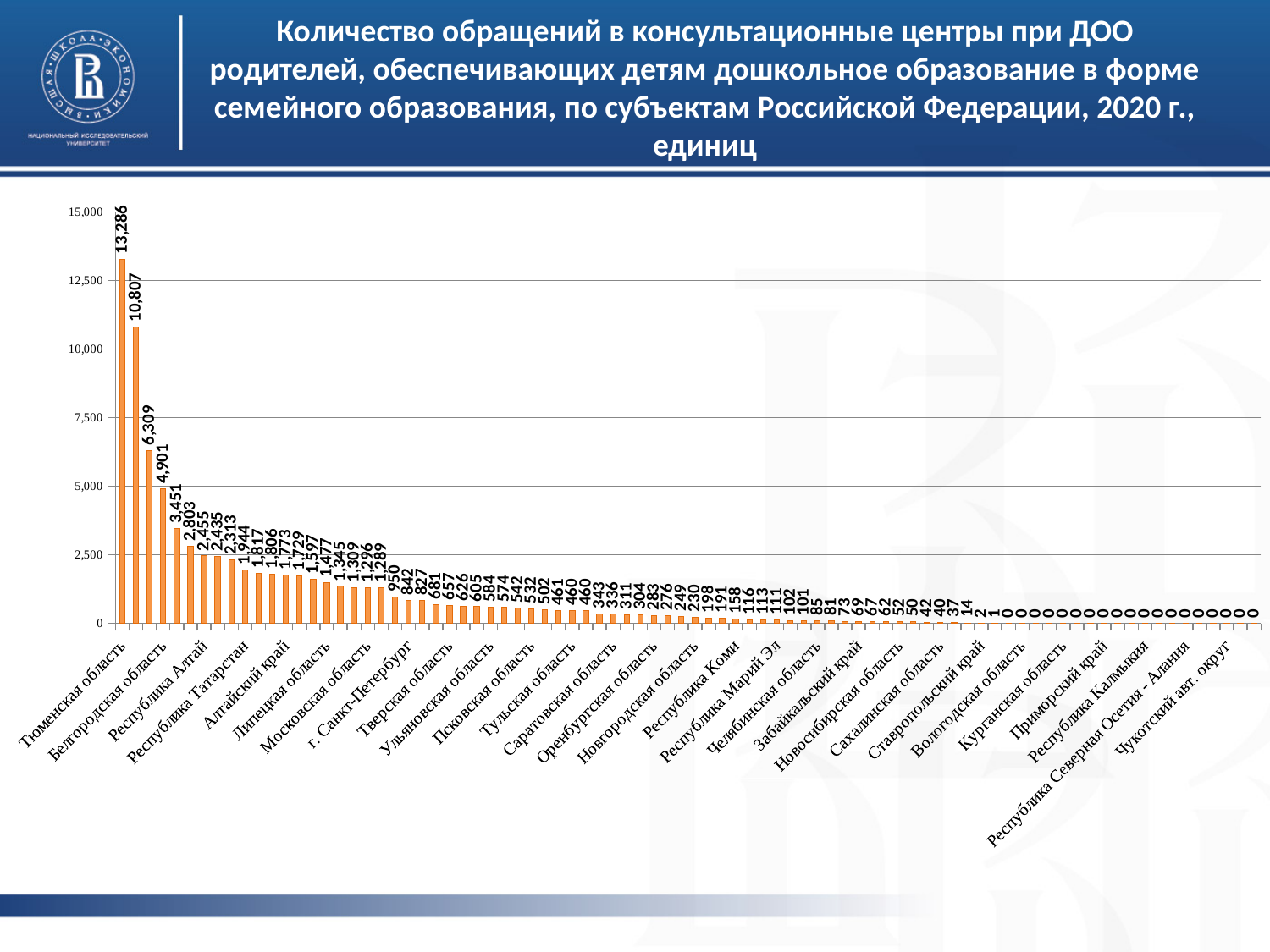
For which year does the chart title say the data is given? 2020 г. What is the difference between the two highest bars (13,286 and 10,807)? 2,479 Which region has the highest number of requests on the chart? Тюменская область Is the value for Тюменская область greater or less than 12,500? greater What is the value shown for Тюменская область? 13,286 What is the value of the second-highest bar on the chart? 10,807 What is the value shown for Чукотский авт. округ? 0 Do the values rise or fall moving from left to right along the x axis? fall What is the difference between the highest bar (13,286) and the third-highest bar (6,309)? 6,977 What is the value of the third-highest bar on the chart? 6,309 What is the highest tick value shown on the vertical axis? 15,000 What kind of chart is shown on the slide? bar chart